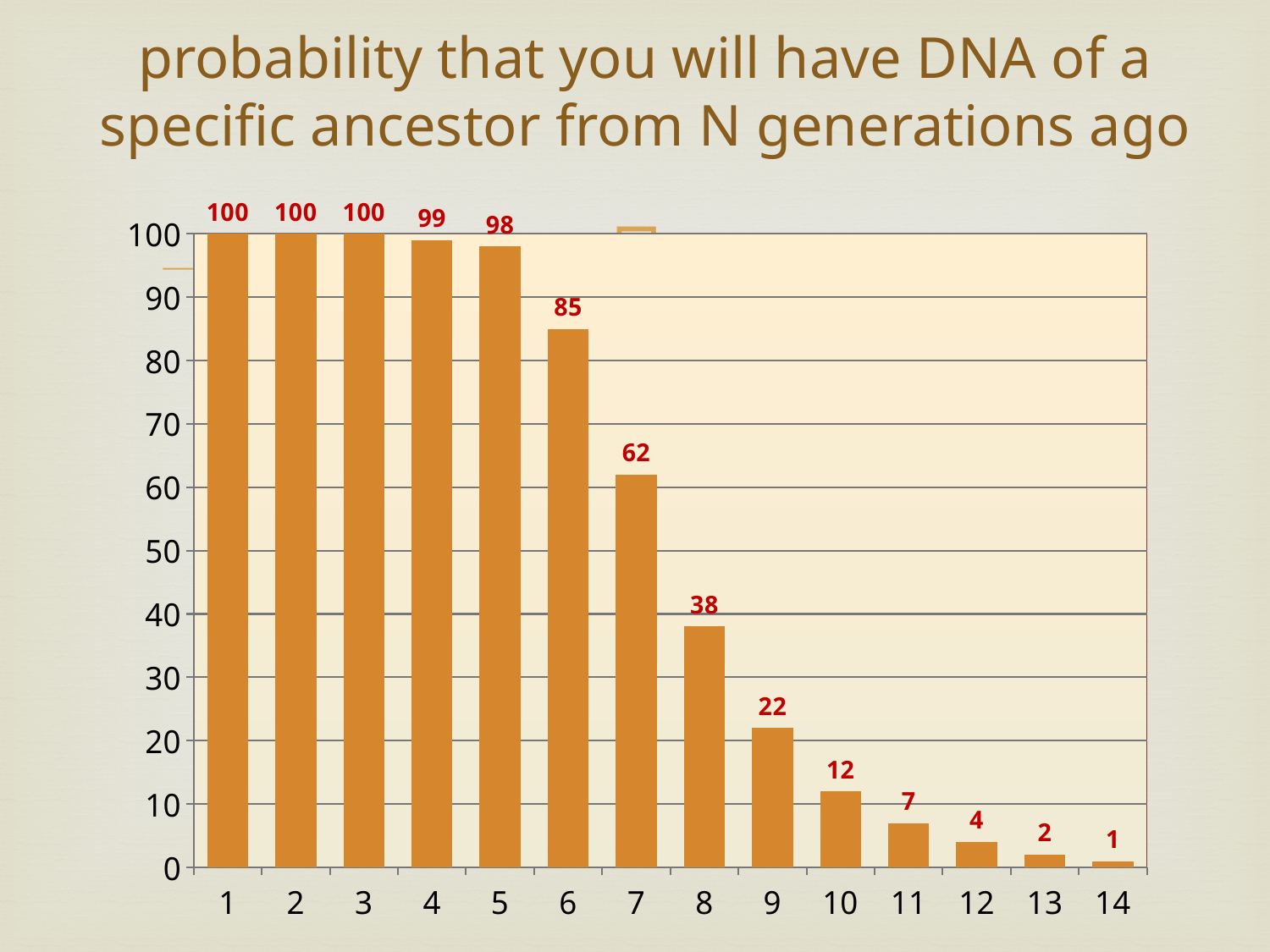
What is the difference between the values for generation 9 and generation 11? 15 What is the value for generation 10? 12 Which generation has the lowest value? 14 Which is larger, the value for generation 8 or the value for generation 9? generation 8 What is the value for generation 7? 62 What kind of chart is shown on the slide? bar chart Do the values rise or fall as the number of generations increases along the x axis? fall What is the value for generation 5? 98 How many generations (bars) are shown on the x axis? 14 What is the difference between the values for generation 6 and generation 8? 47 Is the value for generation 7 greater or less than 50? greater What is the title of the chart? probability that you will have DNA of a specific ancestor from N generations ago